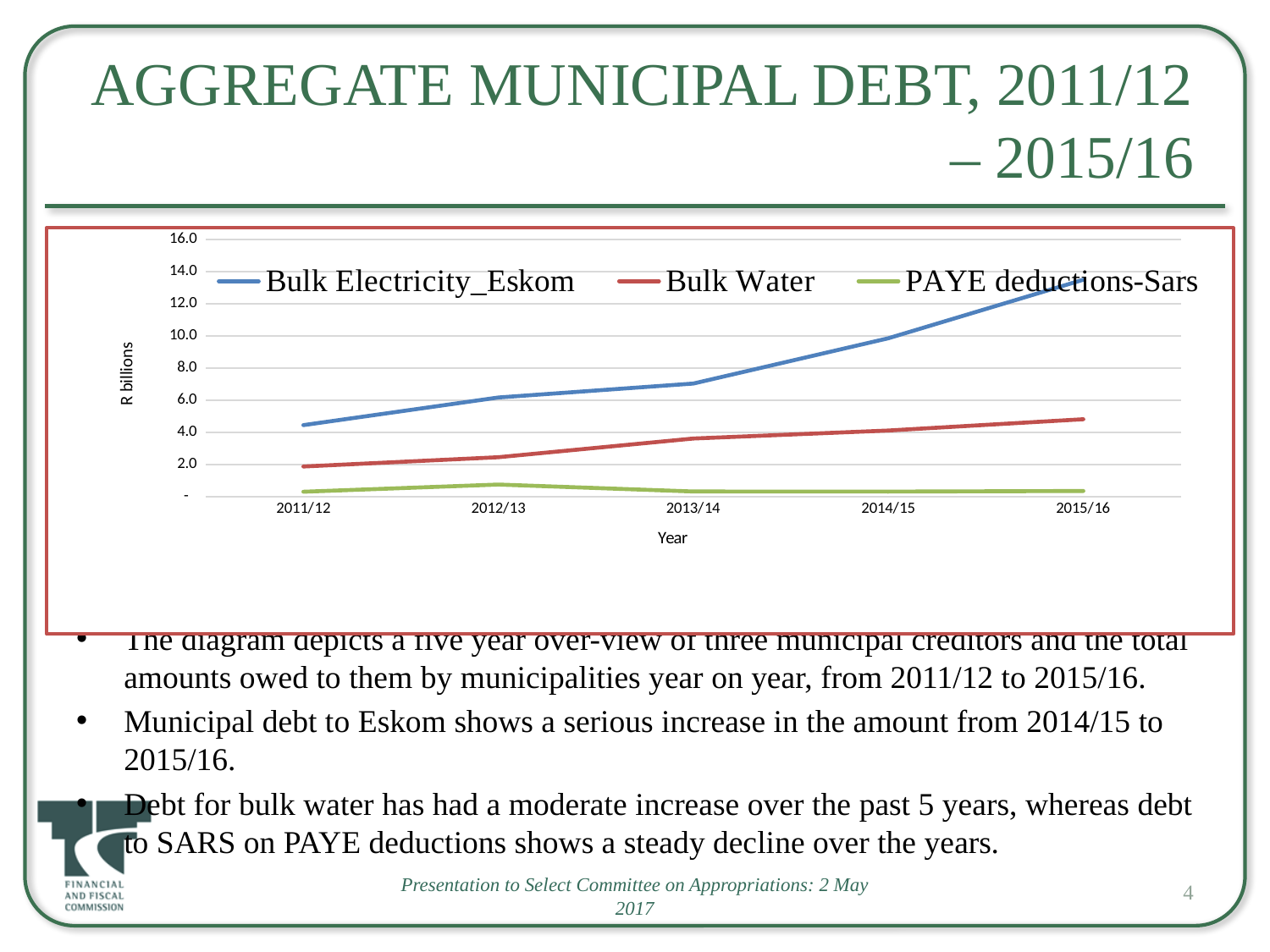
Is the value for Bulk Electricity_Eskom in 2015/16 greater or less than 12.0? greater What kind of chart is shown on the slide? line chart In which year is the Bulk Electricity_Eskom value highest? 2015/16 Is the value for Bulk Water in 2015/16 greater or less than 4.0? greater Is the value for PAYE deductions-Sars in 2012/13 greater or less than 2.0? less How many years are shown along the x axis? 5 Does the Bulk Electricity_Eskom line rise or fall from 2011/12 to 2015/16? rise How many series does the legend list? 3 Which series has the lowest value in 2015/16? PAYE deductions-Sars What is the label on the y axis of the chart? R billions Which series has the highest value in 2015/16? Bulk Electricity_Eskom